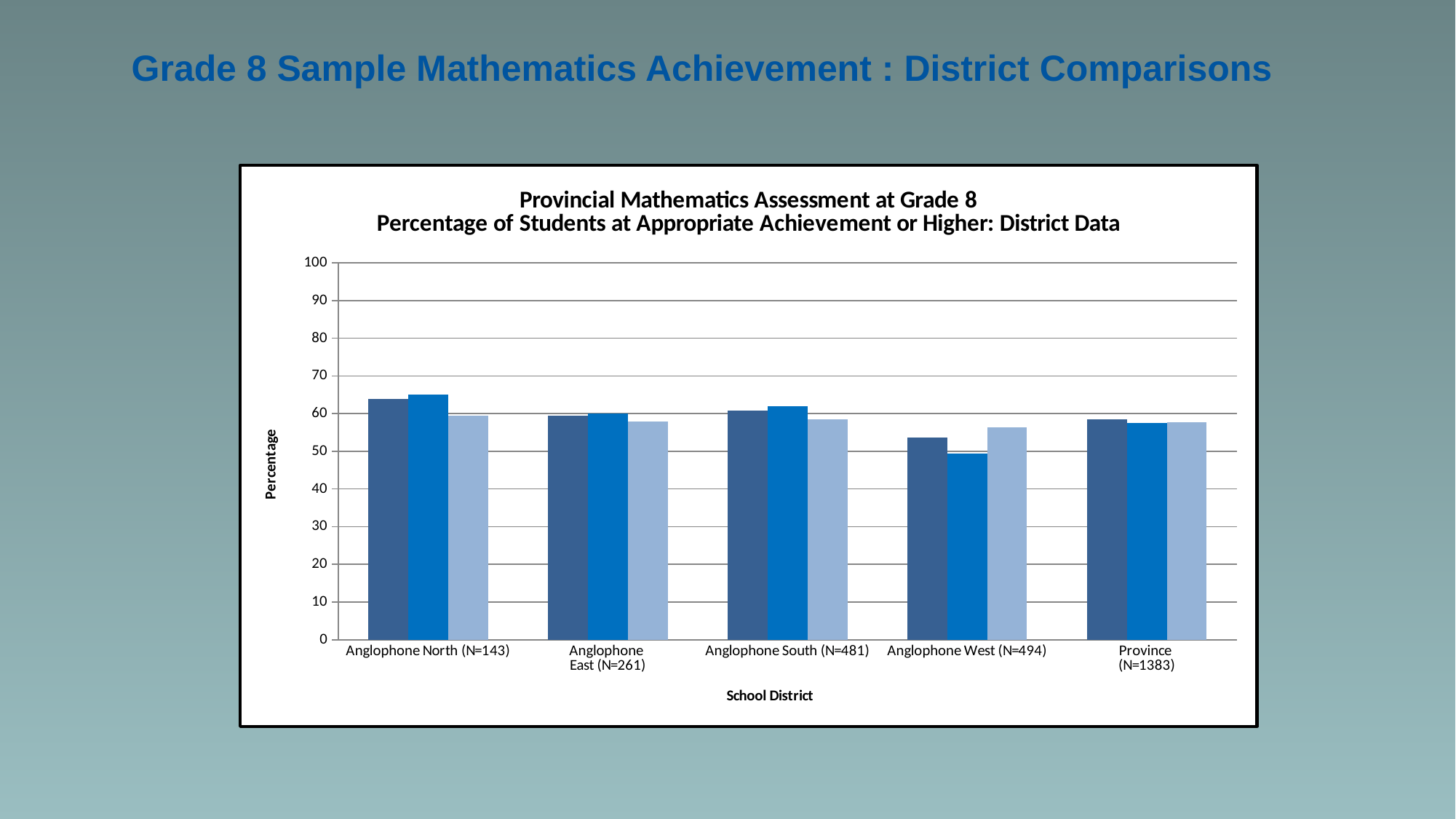
How many bars are plotted for each school district in the chart? 3 Is the value of the darkest blue bar for Anglophone West (N=494) greater or less than 50? greater Is the value of the medium blue (middle) bar for Anglophone North (N=143) greater or less than 60? greater What is the label on the vertical axis of the chart? Percentage Is the value of the darkest blue bar for Province (N=1383) greater or less than 50? greater Which school district has the shortest bar in the chart? Anglophone West (N=494) Which school district has the tallest bar in the chart? Anglophone North (N=143) What kind of chart is shown on the slide? bar chart How many school districts (categories) are shown on the x axis of the chart? 5 Which is larger: the darkest blue bar for Anglophone North (N=143) or the darkest blue bar for Anglophone West (N=494)? Anglophone North (N=143)